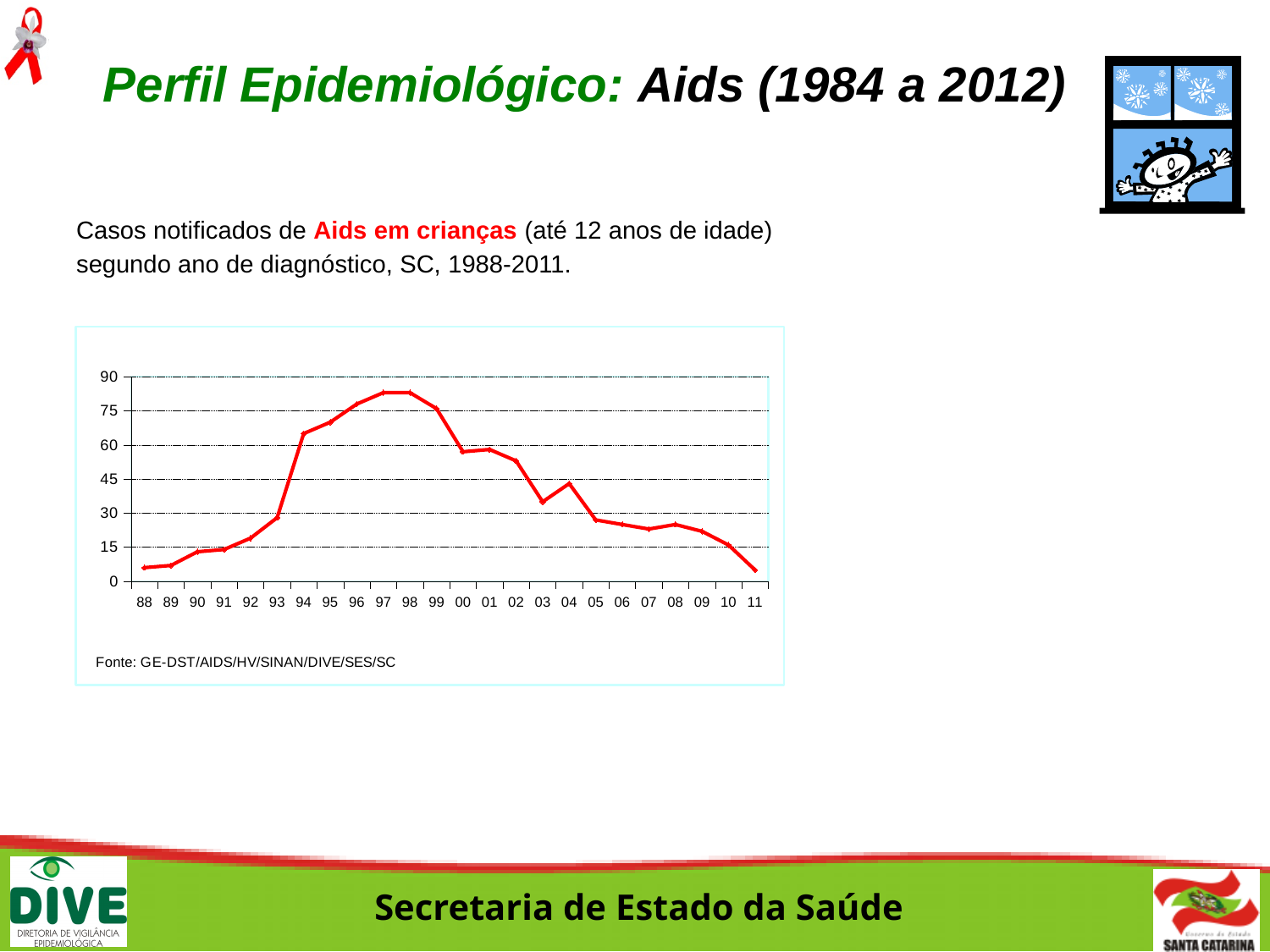
Is the value for 02 greater or less than 45? greater What kind of chart is shown on the slide? line chart Is the value for 97 greater or less than 75? greater Is the value for 11 greater or less than 15? less Which year has the larger value, 03 or 04? 04 What source is cited below the chart? GE-DST/AIDS/HV/SINAN/DIVE/SES/SC Which year has the larger value, 93 or 94? 94 Do the values generally rise or fall from 98 to 11? fall How many years (data points) are plotted along the x axis? 24 Do the values generally rise or fall from 88 to 97? rise